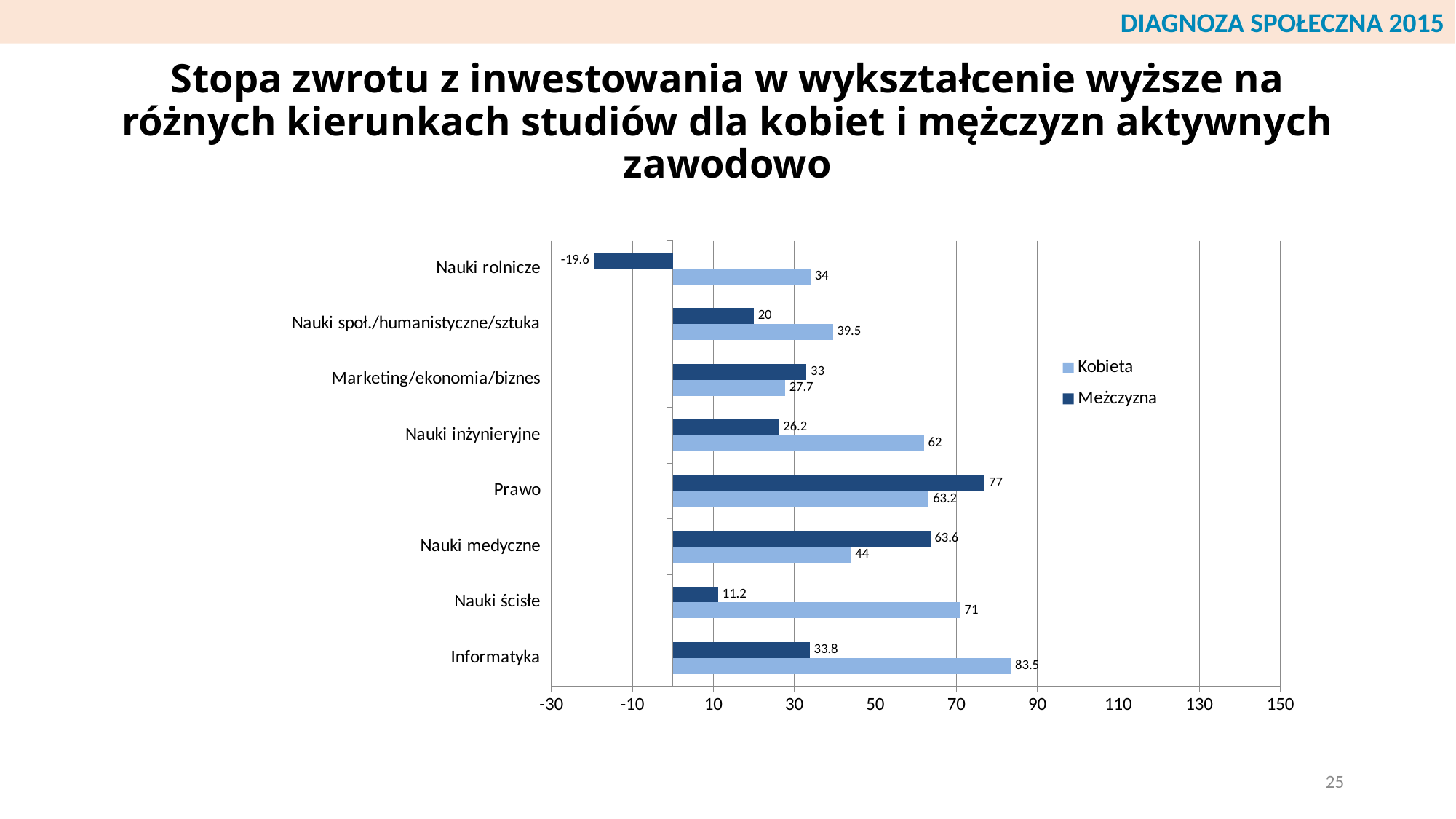
Which series is shown in dark blue in the legend? Mężczyzna How many series does the legend list? 2 Is the value for Kobieta in Nauki inżynieryjne greater or less than 50? greater What is the value for Mężczyzna in Prawo? 77 Which is larger in Nauki medyczne, the value for Kobieta or for Mężczyzna? Mężczyzna Which category has the lowest value for Mężczyzna? Nauki rolnicze What is the value for Mężczyzna in Nauki rolnicze? -19.6 How many categories (fields of study) are shown on the chart? 8 What is the value for Kobieta in Informatyka? 83.5 What kind of chart is shown on the slide? Bar chart What is the difference between the Kobieta and Mężczyzna values for Nauki ścisłe? 59.8 Which category has the highest value for Kobieta? Informatyka